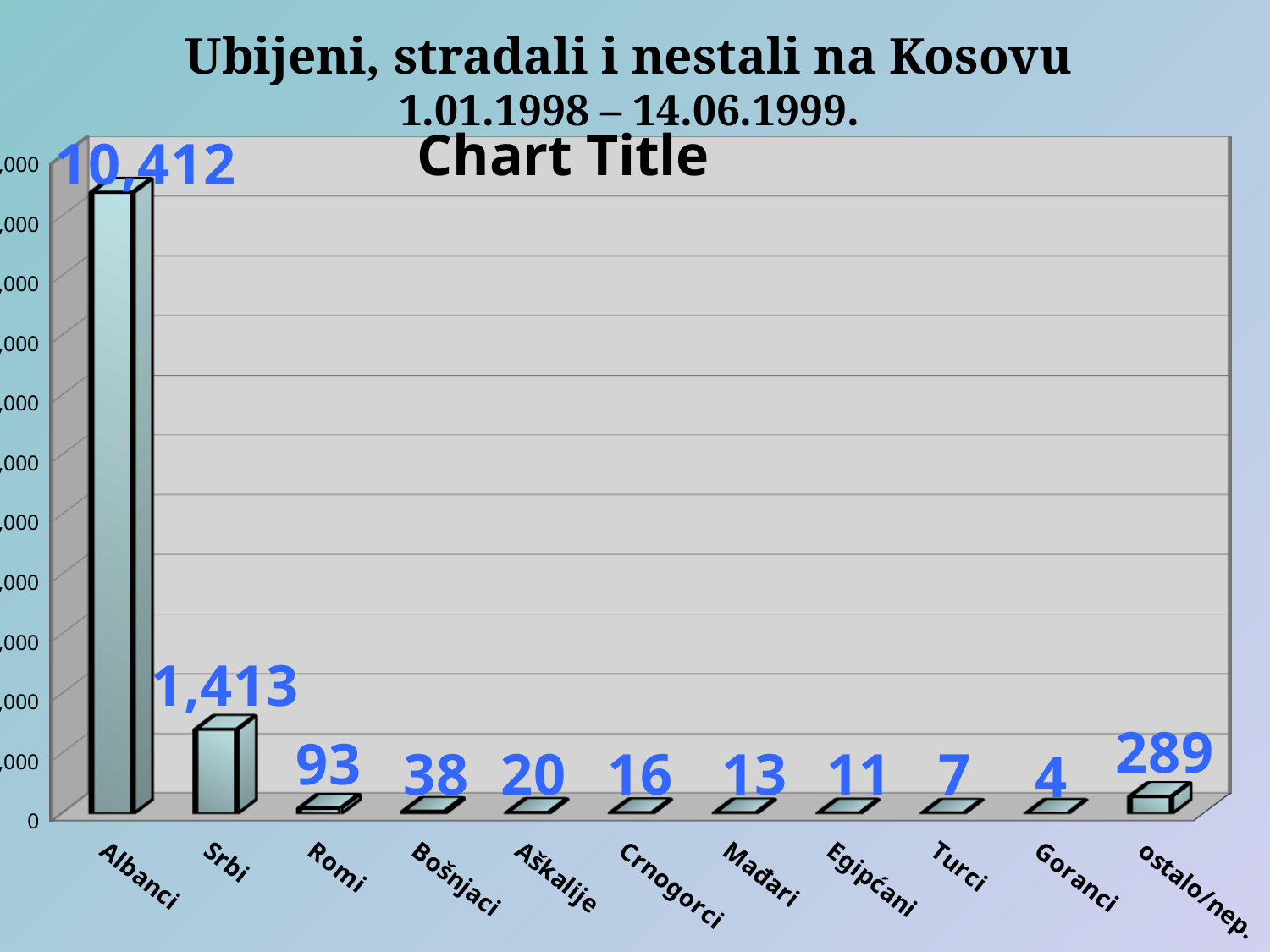
What is the difference between the values for Albanci and Srbi? 8,999 What is the value for Romi? 93 What is the value for Albanci? 10,412 What is the value for Srbi? 1,413 How many categories are shown on the x axis? 11 What is the value for ostalo/nep.? 289 Which category has the highest value? Albanci Which category has the lowest value? Goranci Which is larger, the value for Romi or the value for ostalo/nep.? ostalo/nep. What is the difference between the values for Bošnjaci and Aškalije? 18 What kind of chart is shown on the slide? bar chart What title is printed inside the chart area? Chart Title